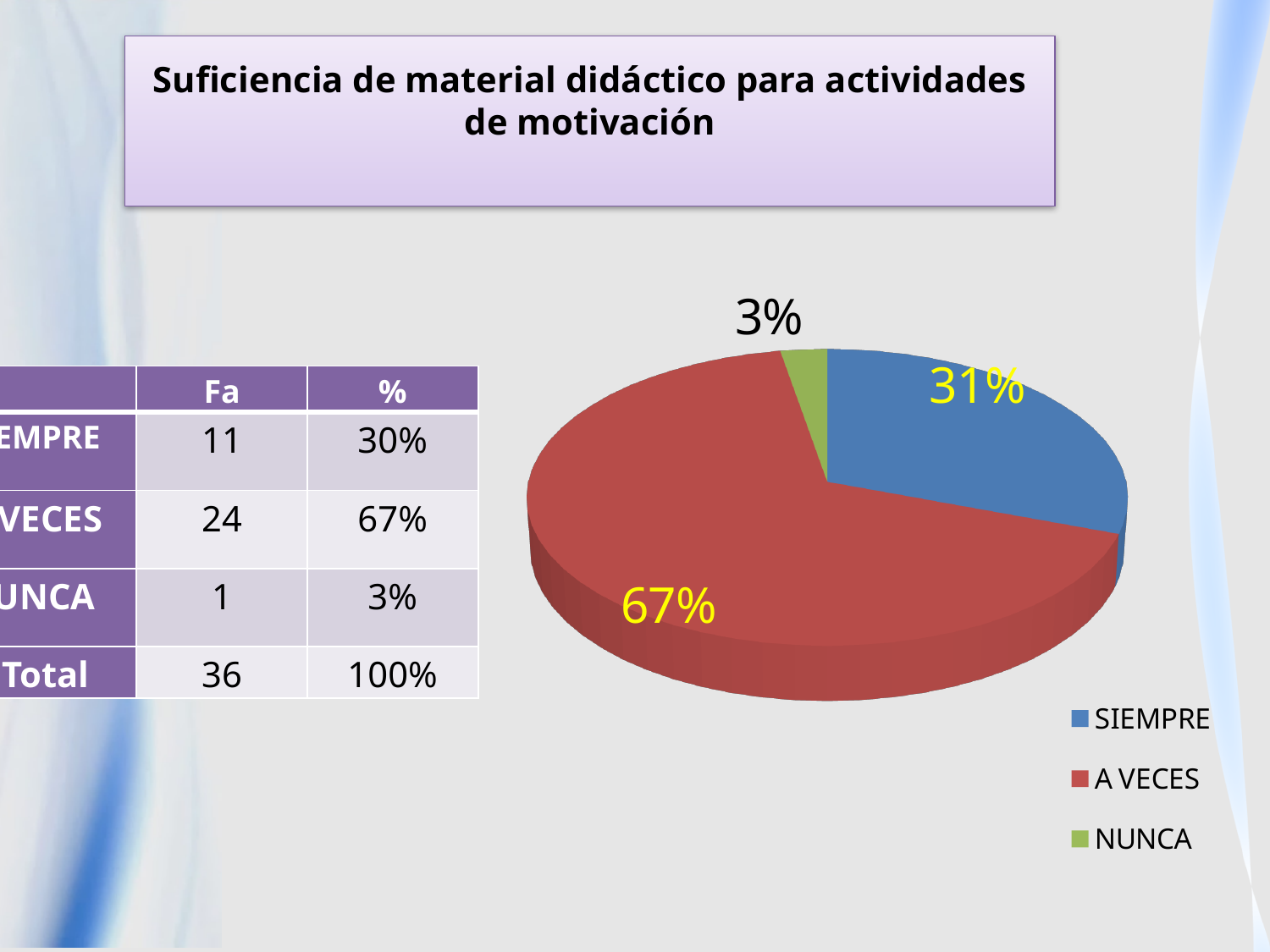
Which slice is larger in the pie chart, SIEMPRE or NUNCA? SIEMPRE What colour is the A VECES slice in the pie chart? red What colour is the NUNCA slice in the pie chart? green How many categories does the pie chart legend list? 3 Which category has the smallest slice in the pie chart? NUNCA What is the difference in percentage points between the SIEMPRE slice and the NUNCA slice in the pie chart? 28 What kind of chart is shown on the slide? pie chart What percentage does the pie chart show for NUNCA? 3% Which category has the largest slice in the pie chart? A VECES What percentage does the pie chart show for SIEMPRE? 31% What is the difference in percentage points between the A VECES slice and the SIEMPRE slice in the pie chart? 36 What percentage does the pie chart show for A VECES? 67%